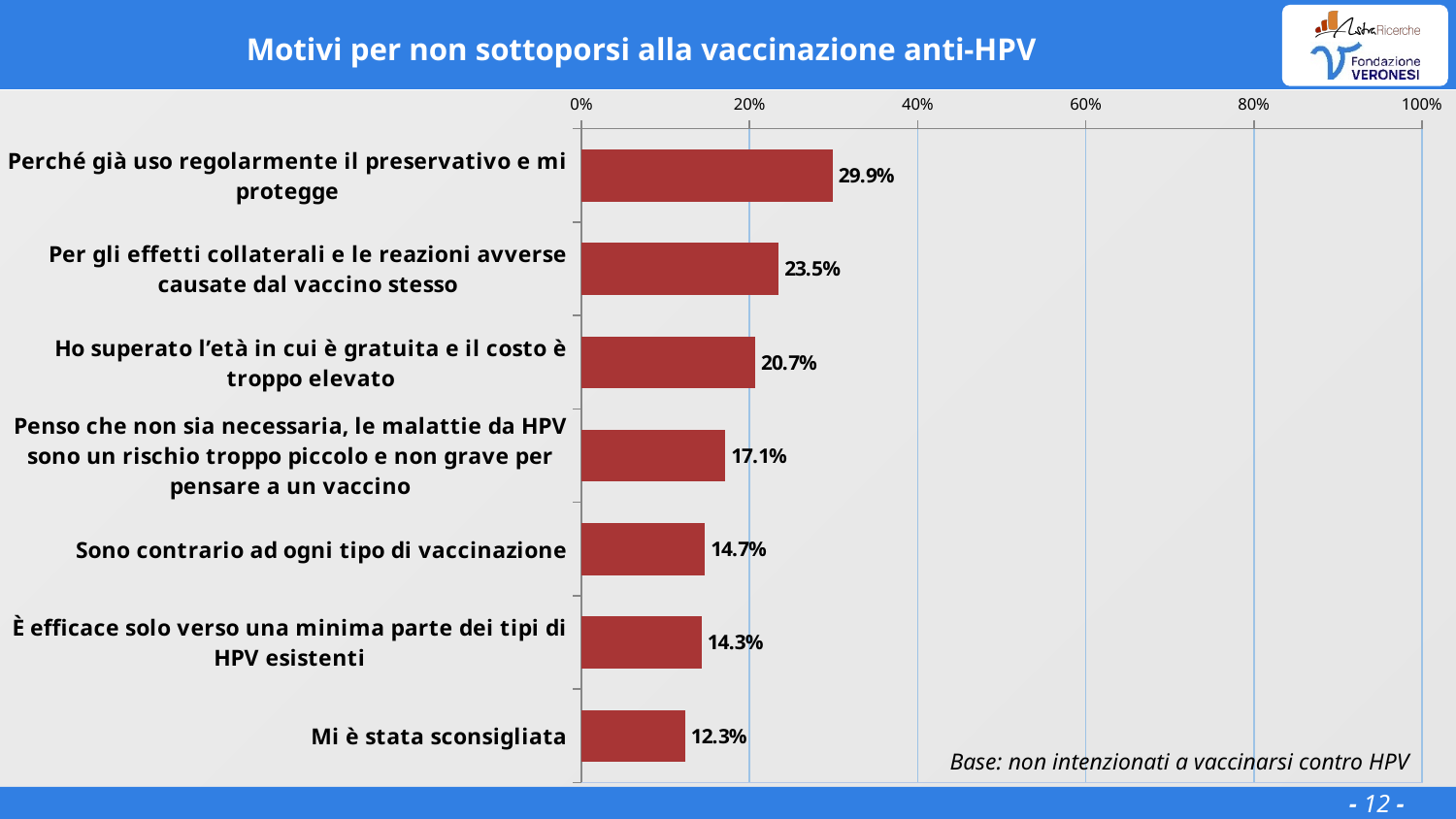
What kind of chart is shown on the slide? Bar chart What is the difference between the values for "Perché già uso regolarmente il preservativo e mi protegge" and "Per gli effetti collaterali e le reazioni avverse causate dal vaccino stesso"? 6.4% Which reason has the highest value? Perché già uso regolarmente il preservativo e mi protegge What is the value for "Sono contrario ad ogni tipo di vaccinazione"? 14.7% What is the value for "Mi è stata sconsigliata"? 12.3% What is the title of the chart? Motivi per non sottoporsi alla vaccinazione anti-HPV How many reasons (categories) are shown in the chart? 7 Which reason has the lowest value? Mi è stata sconsigliata What is the base (population) noted on the chart? Non intenzionati a vaccinarsi contro HPV What is the value for "Ho superato l'età in cui è gratuita e il costo è troppo elevato"? 20.7% Which is larger: the value for "Penso che non sia necessaria..." or the value for "È efficace solo verso una minima parte dei tipi di HPV esistenti"? Penso che non sia necessaria, le malattie da HPV sono un rischio troppo piccolo e non grave per pensare a un vaccino Is the value for "Per gli effetti collaterali e le reazioni avverse causate dal vaccino stesso" greater or less than 20%? greater